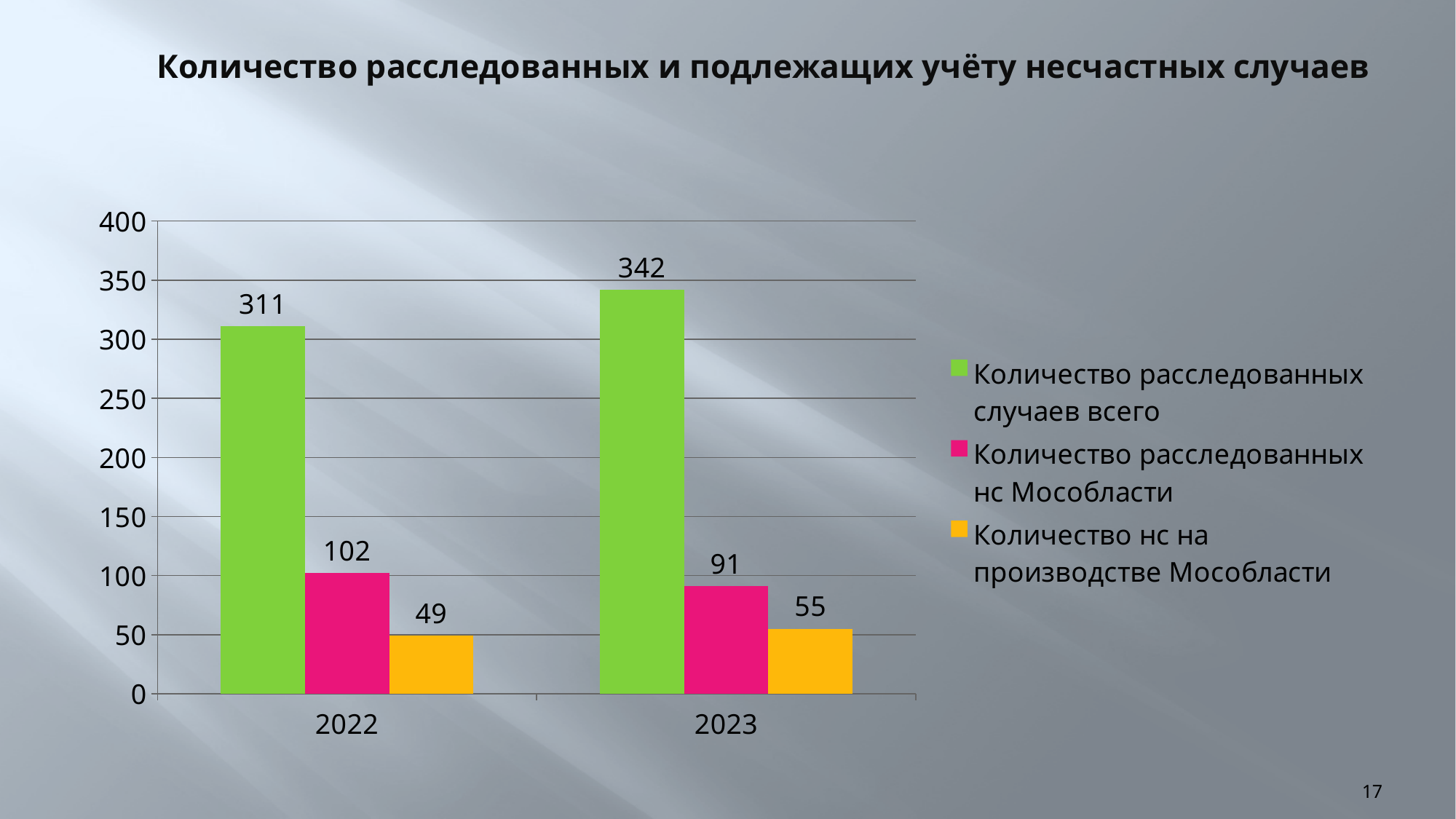
What is the value of "Количество нс на производстве Мособласти" for 2022? 49 What is the value of "Количество расследованных нс Мособласти" for 2023? 91 What is the difference between "Количество расследованных случаев всего" in 2023 and in 2022? 31 Which is larger: "Количество нс на производстве Мособласти" in 2022 or in 2023? 2023 What is the difference between "Количество расследованных нс Мособласти" and "Количество нс на производстве Мособласти" in 2022? 53 How many years are shown on the x axis? 2 In which year is "Количество расследованных случаев всего" highest? 2023 In which year is "Количество расследованных нс Мособласти" lowest? 2023 How many series does the legend list? 3 What kind of chart is shown on the slide? Bar chart Which colour represents "Количество нс на производстве Мособласти" in the legend? Orange What is the value of "Количество расследованных случаев всего" for 2022? 311